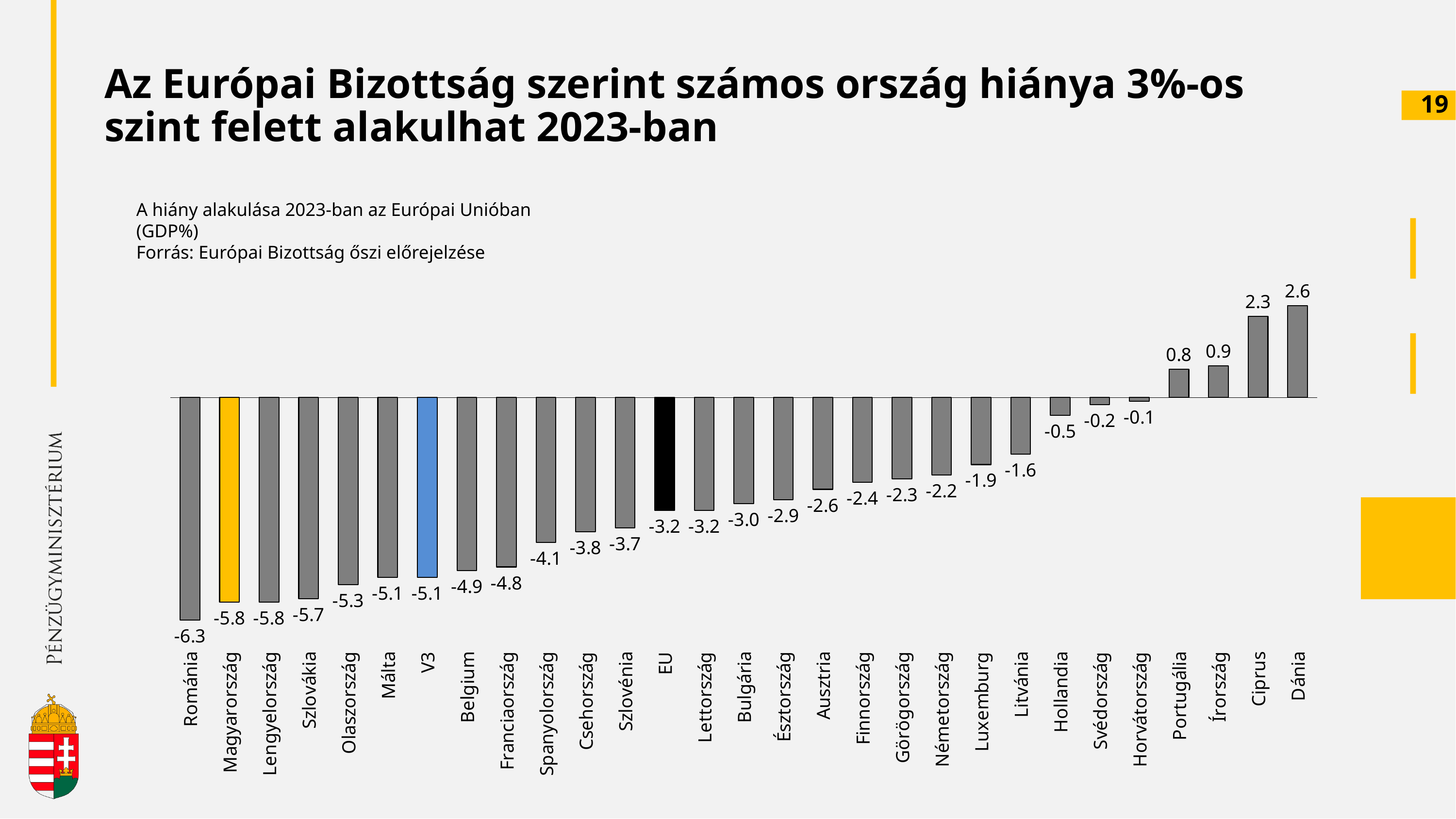
Which category has the highest value? Dánia What is the value for Magyarország? -5.8 Which category has the lowest value? Románia What is the difference between the values for Románia and Magyarország? 0.5 What is the value for Németország? -2.2 What colour is the bar for Magyarország? Yellow What kind of chart is shown on the slide? Bar chart Which is larger, the value for Belgium or the value for Hollandia? Hollandia What is the difference between the values for Dánia and Ciprus? 0.3 How many categories are shown on the x axis? 29 What is the value for Dánia? 2.6 What is the value for EU? -3.2